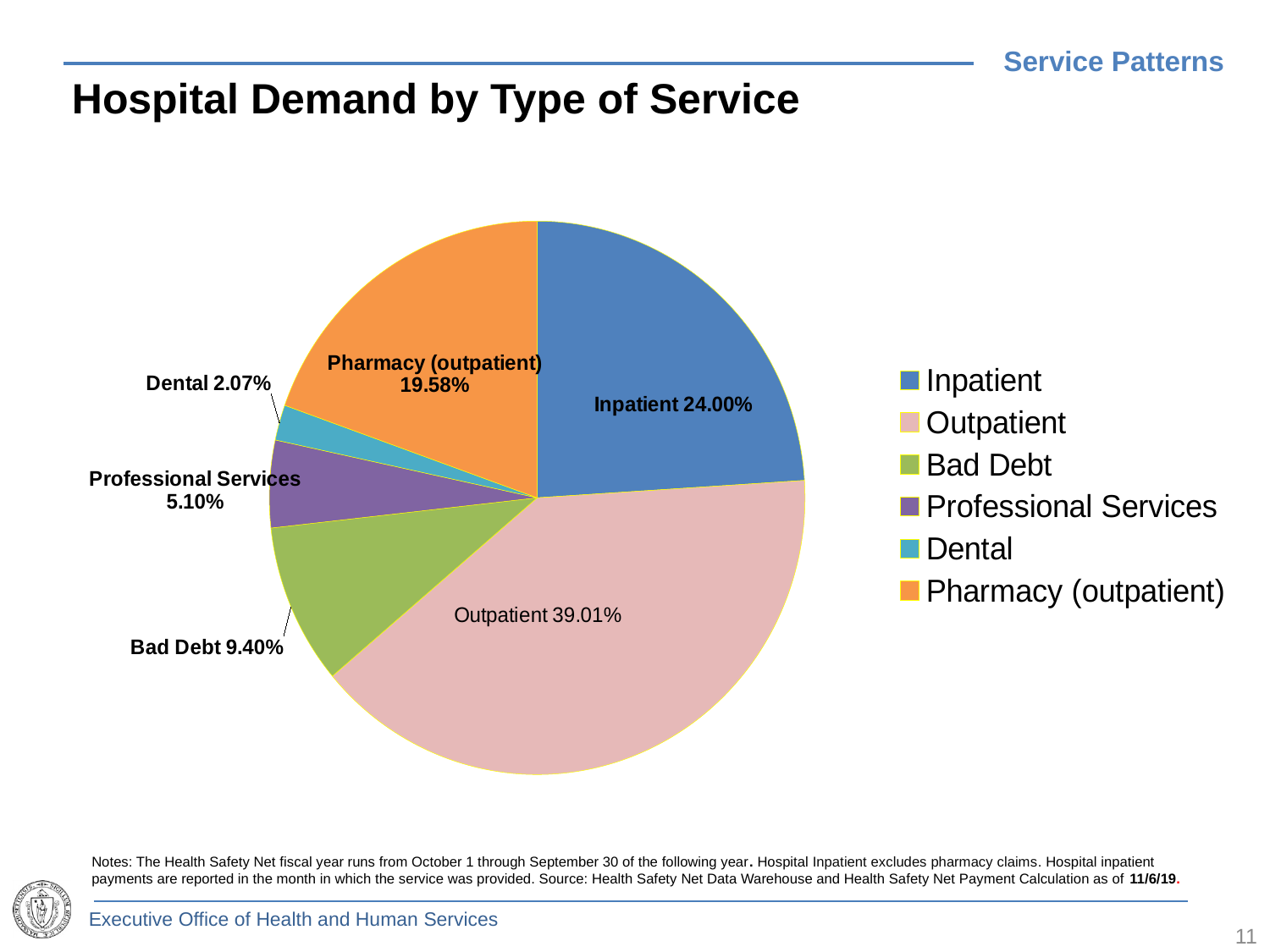
What share of hospital demand is Inpatient? 24.00% What share of hospital demand is Pharmacy (outpatient)? 19.58% How many types of service are shown in the pie chart? 6 Which type of service has the smallest share of hospital demand? Dental What is the title of the chart? Hospital Demand by Type of Service What share of hospital demand is Bad Debt? 9.40% What share of hospital demand is Dental? 2.07% What kind of chart is shown on the slide? Pie chart What is the difference in percentage points between the Outpatient and Inpatient shares? 15.01 Which is larger, the Professional Services share or the Bad Debt share? Bad Debt Which type of service has the largest share of hospital demand? Outpatient What share of hospital demand is Outpatient? 39.01%